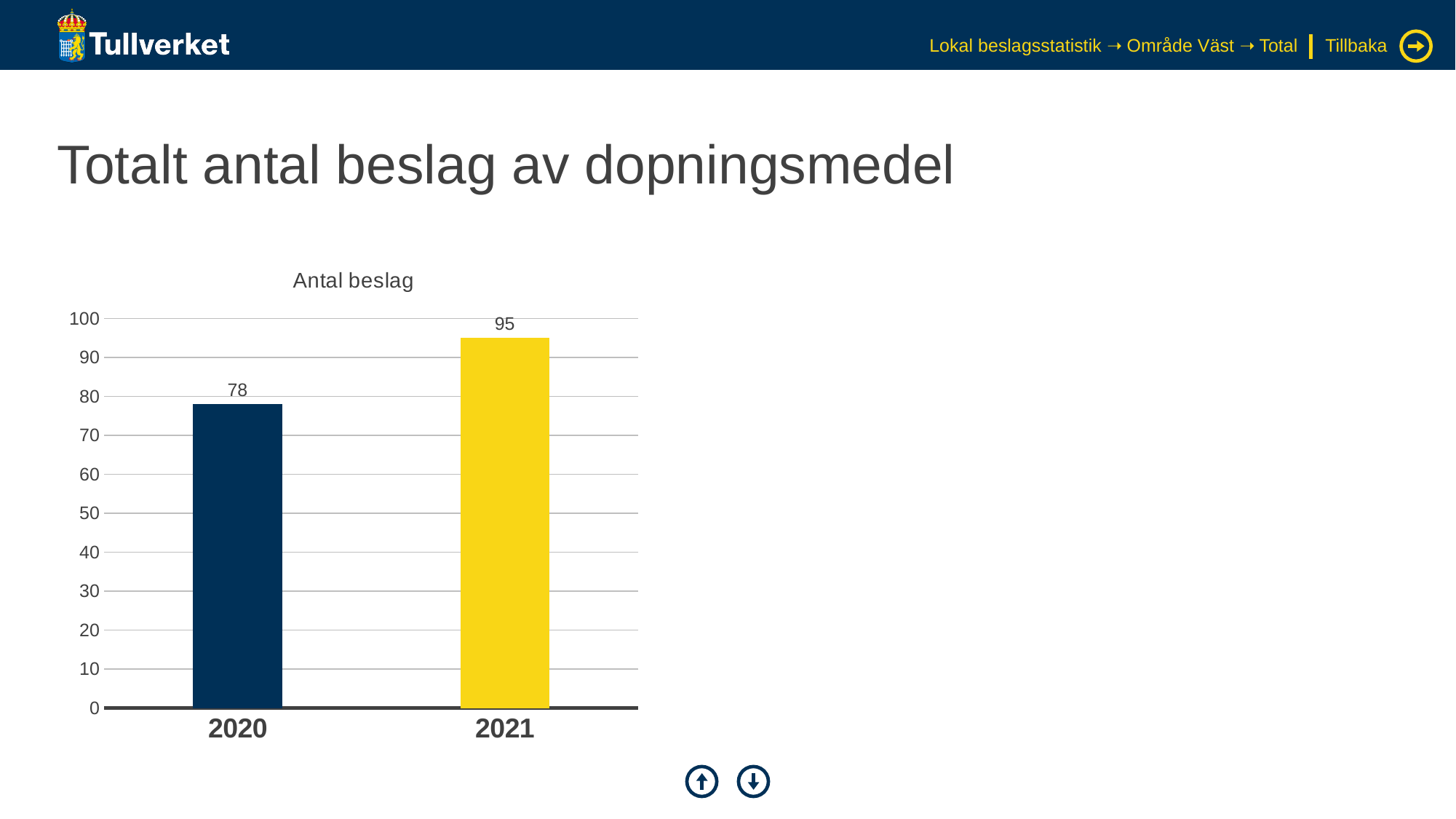
Is the value for 2020 greater or less than 80? less How many years are shown on the x axis? 2 Is the value for 2021 greater or less than 90? greater Which year has the lowest value? 2020 What is the value for 2021? 95 What is the difference between the values for 2021 and 2020? 17 Do the values rise or fall from 2020 to 2021? rise What kind of chart is shown? bar chart Which year has the highest value? 2021 What is the value for 2020? 78 Which is larger, the value for 2020 or the value for 2021? 2021 What is the title of the chart? Antal beslag